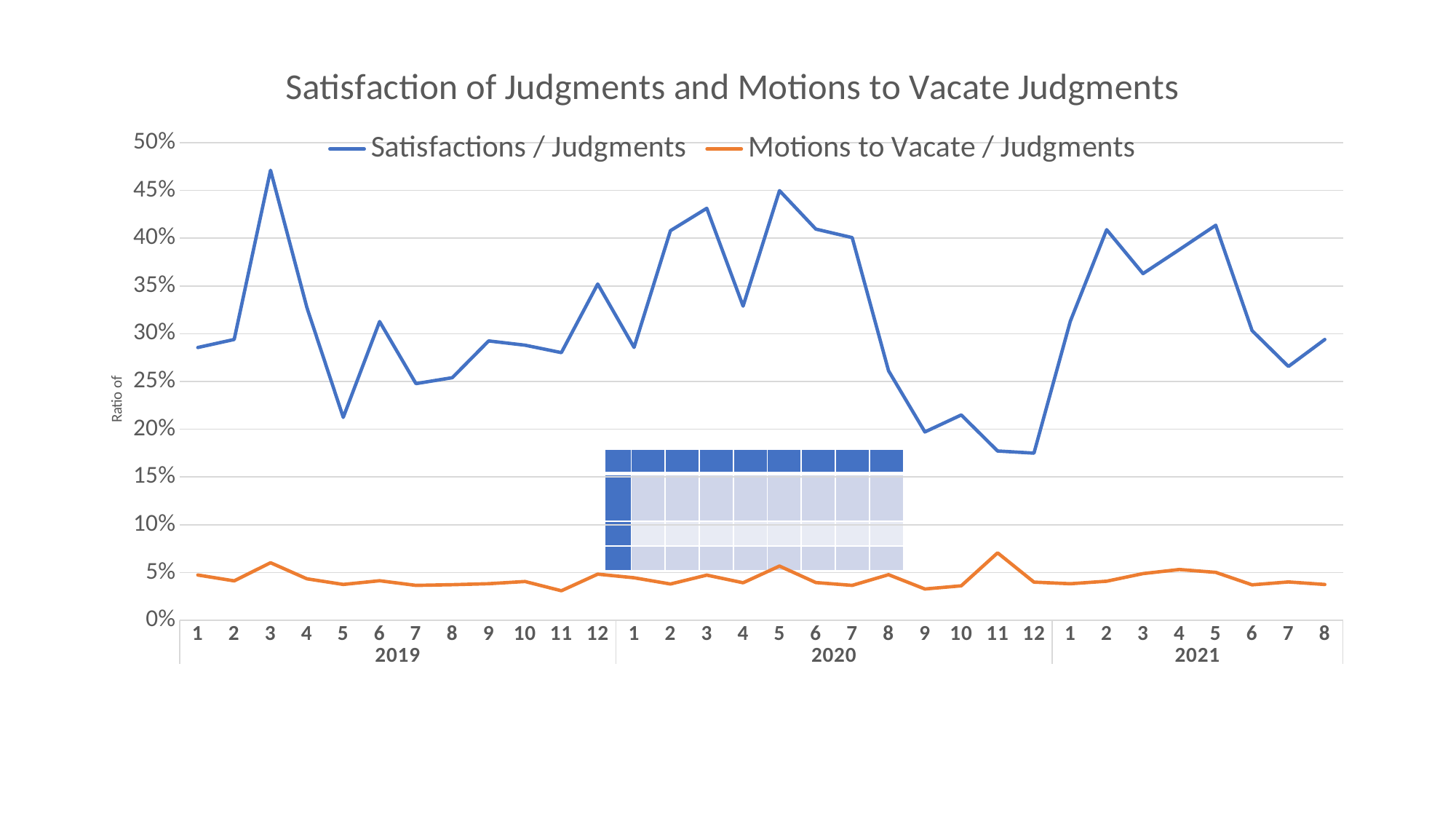
How many monthly data points are plotted along the x axis? 32 Is the Satisfactions / Judgments value for month 3 of 2019 greater or less than 45%? greater What kind of chart is shown on the slide? line chart Is the Motions to Vacate / Judgments value for month 11 of 2020 greater or less than 10%? less What is the title of the chart? Satisfaction of Judgments and Motions to Vacate Judgments Is the Satisfactions / Judgments value for month 11 of 2020 greater or less than 20%? less In which month and year does the Motions to Vacate / Judgments series reach its highest value? Month 11 of 2020 Which colour is used for the Motions to Vacate / Judgments line? orange Does the Satisfactions / Judgments series rise or fall from month 8 of 2020 to month 11 of 2020? fall How many series does the legend list? 2 In which month and year does the Satisfactions / Judgments series reach its highest value? Month 3 of 2019 Which is larger for Satisfactions / Judgments: month 3 of 2019 or month 5 of 2019? Month 3 of 2019